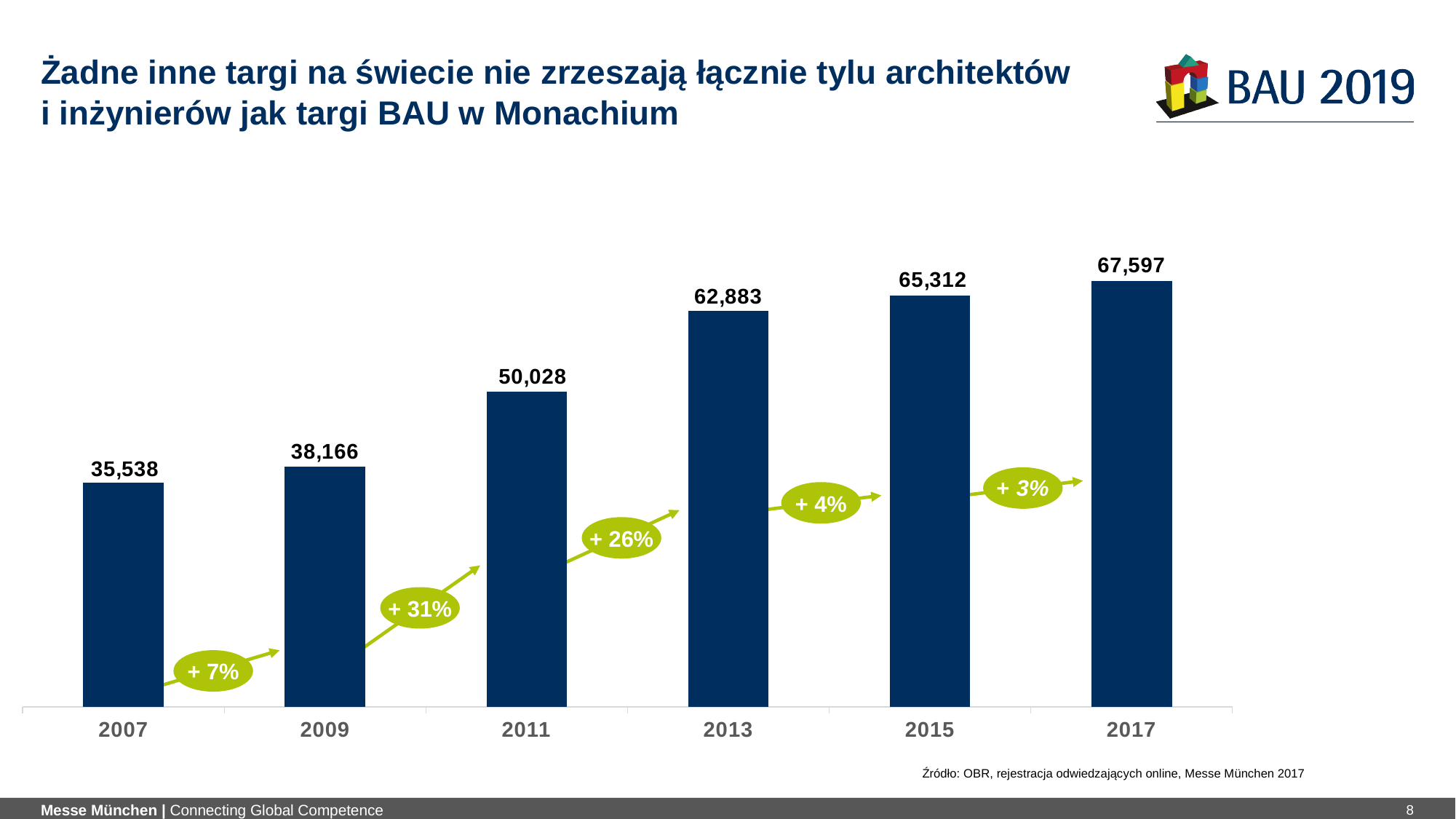
Which is larger, the value for 2009 or the value for 2011? 2011 How many years are shown on the x axis? 6 Do the values rise or fall from 2007 to 2017? Rise What is the value shown for 2015? 65,312 What is the difference between the values for 2017 and 2015? 2,285 What is the value shown for 2011? 50,028 Which year has the lowest value? 2007 What kind of chart is shown on the slide? Bar chart What is the value shown for 2007? 35,538 What is the difference between the values for 2013 and 2011? 12,855 Which year has the highest value? 2017 What percentage change is labelled between 2009 and 2011? + 31%